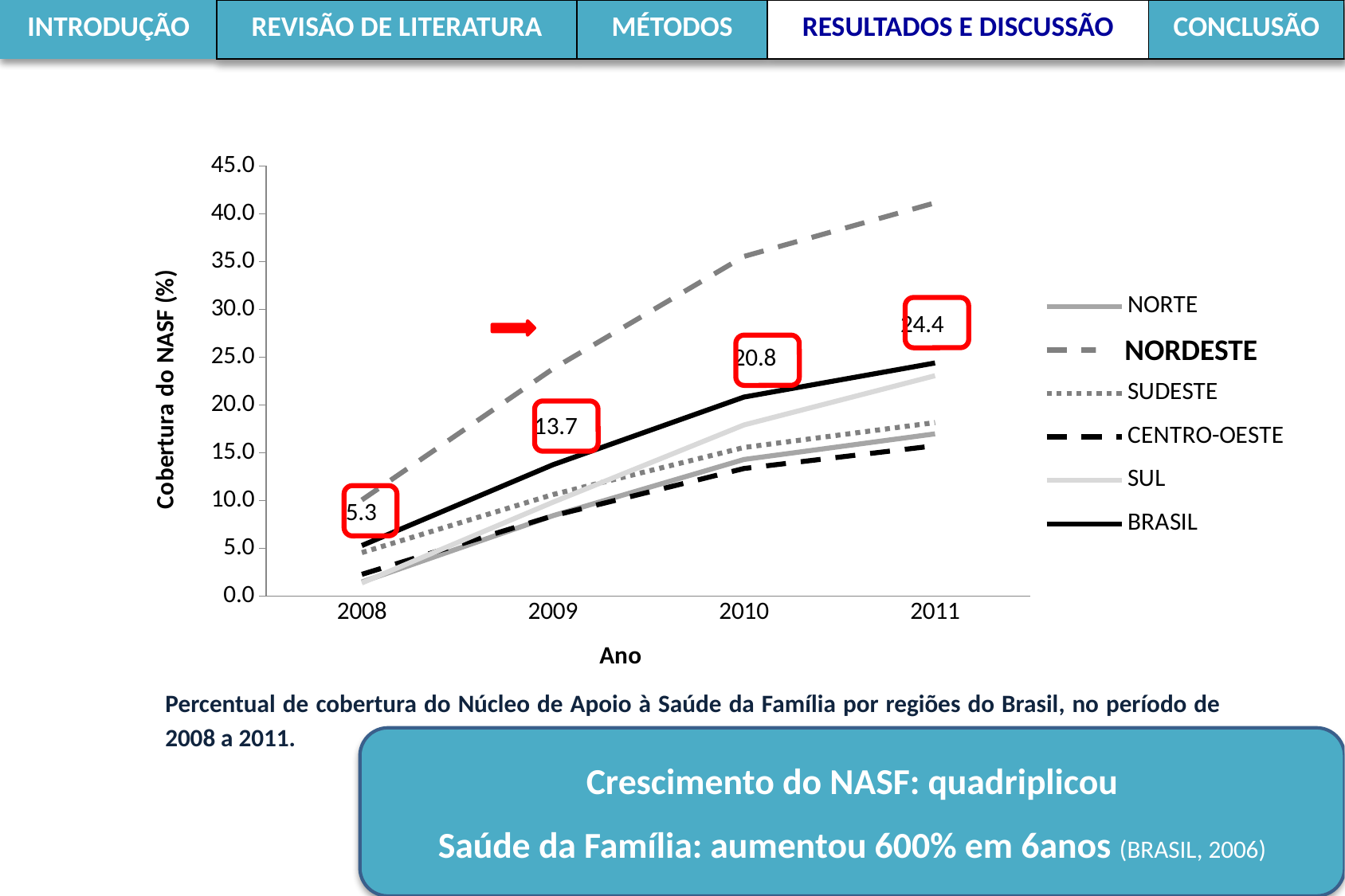
What is the value for BRASIL in 2009? 13.7 Does the BRASIL line rise or fall from 2008 to 2011? rises What is the value for BRASIL in 2011? 24.4 Which region has the highest coverage in 2011? NORDESTE How many years are shown on the x axis? 4 What is the label of the y axis? Cobertura do NASF (%) What kind of chart is shown on the slide? line chart How many series does the legend list? 6 By how much did the BRASIL value increase from 2008 to 2011? 19.1 Is the value for NORDESTE in 2010 greater or less than 30.0? greater What is the value for BRASIL in 2010? 20.8 What is the value for BRASIL in 2008? 5.3